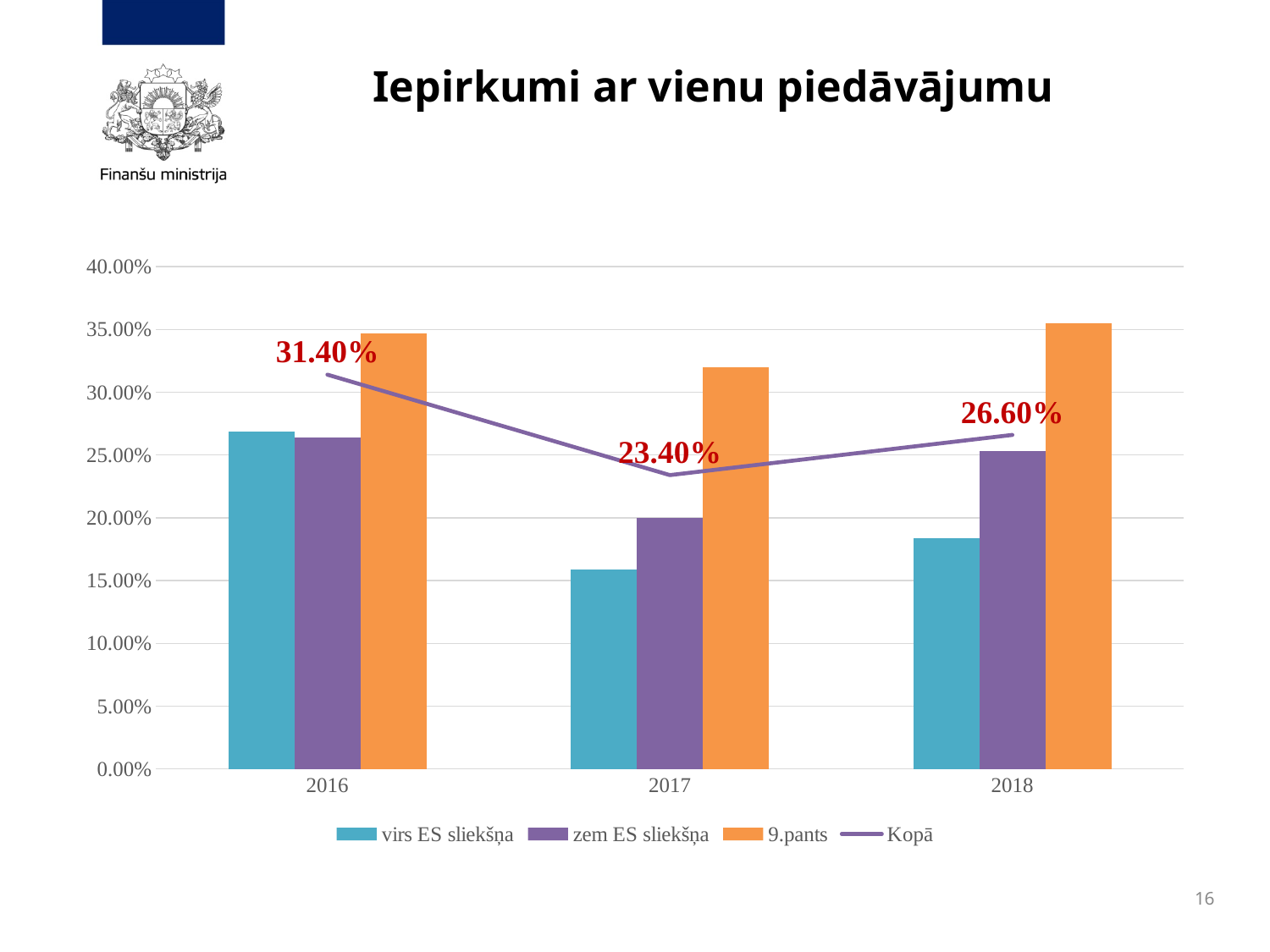
Is the value for virs ES sliekšņa in 2018 greater or less than 20.00%? less What is the value of the Kopā line for 2018? 26.60% In which year is the Kopā value highest? 2016 What is the difference between the Kopā values for 2016 and 2017? 8.00% Does the Kopā line rise or fall from 2017 to 2018? rise How many years are shown on the x axis? 3 What is the value of the Kopā line for 2016? 31.40% Which series has the tallest bar in 2017? 9.pants In which year is the Kopā value lowest? 2017 How many series does the legend list? 4 What is the value of the Kopā line for 2017? 23.40% Is the value for 9.pants in 2016 greater or less than 30.00%? greater